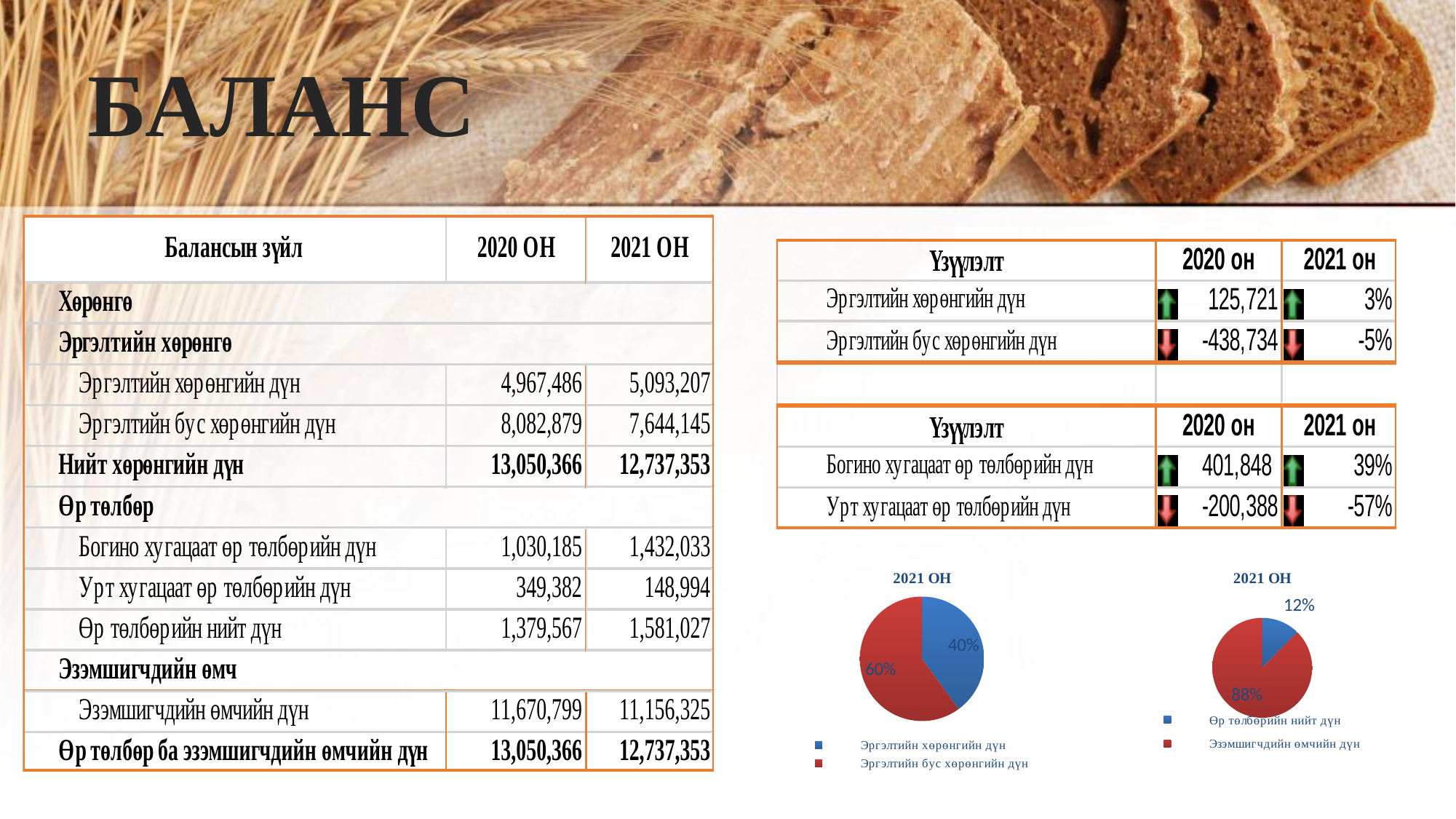
In the left pie chart, what share does Эргэлтийн бус хөрөнгийн дүн have? 60% In the right pie chart, what share does Өр төлбөрийн нийт дүн have? 12% In the left pie chart, which category has the largest slice? Эргэлтийн бус хөрөнгийн дүн In the right pie chart, which category has the smallest slice? Өр төлбөрийн нийт дүн What type of chart is the chart on the right side of the slide? Pie chart What is the title of the left pie chart? 2021 ОН In the right pie chart, what colour is the slice for Эзэмшигчдийн өмчийн дүн? Red In the left pie chart, what share does Эргэлтийн хөрөнгийн дүн have? 40% How many slices does the left pie chart have? 2 In the left pie chart, which is larger: Эргэлтийн хөрөнгийн дүн or Эргэлтийн бус хөрөнгийн дүн? Эргэлтийн бус хөрөнгийн дүн In the right pie chart, what is the difference in percentage points between Эзэмшигчдийн өмчийн дүн and Өр төлбөрийн нийт дүн? 76